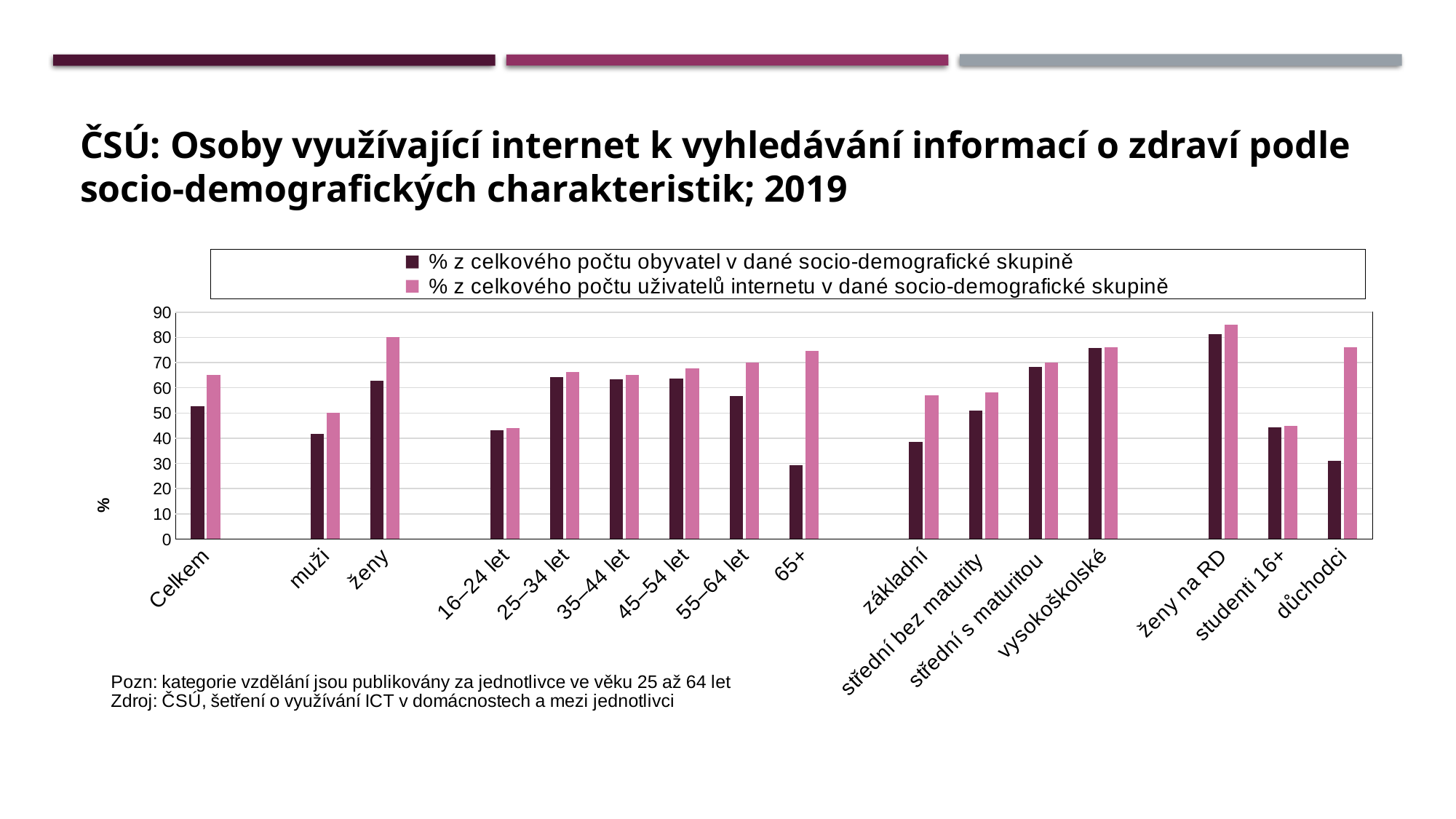
Which category has the highest value for the series '% z celkového počtu obyvatel v dané socio-demografické skupině'? ženy na RD Which category has the lowest value for the series '% z celkového počtu obyvatel v dané socio-demografické skupině'? 65+ Which category has the highest value for the series '% z celkového počtu uživatelů internetu v dané socio-demografické skupině'? ženy na RD What is the label of the y axis? % What kind of chart is shown on the slide? bar chart For the series '% z celkového počtu obyvatel v dané socio-demografické skupině', do the values rise or fall across the education categories from 'základní' to 'vysokoškolské'? rise Is the value for '65+' in the series '% z celkového počtu obyvatel v dané socio-demografické skupině' greater or less than 40? less How many categories are shown on the x axis? 16 Is the value for 'důchodci' in the series '% z celkového počtu uživatelů internetu v dané socio-demografické skupině' greater or less than 70? greater How many series does the legend list? 2 Is the value for 'Celkem' in the series '% z celkového počtu uživatelů internetu v dané socio-demografické skupině' greater or less than 60? greater For the series '% z celkového počtu obyvatel v dané socio-demografické skupině', which is larger: 'muži' or 'ženy'? ženy